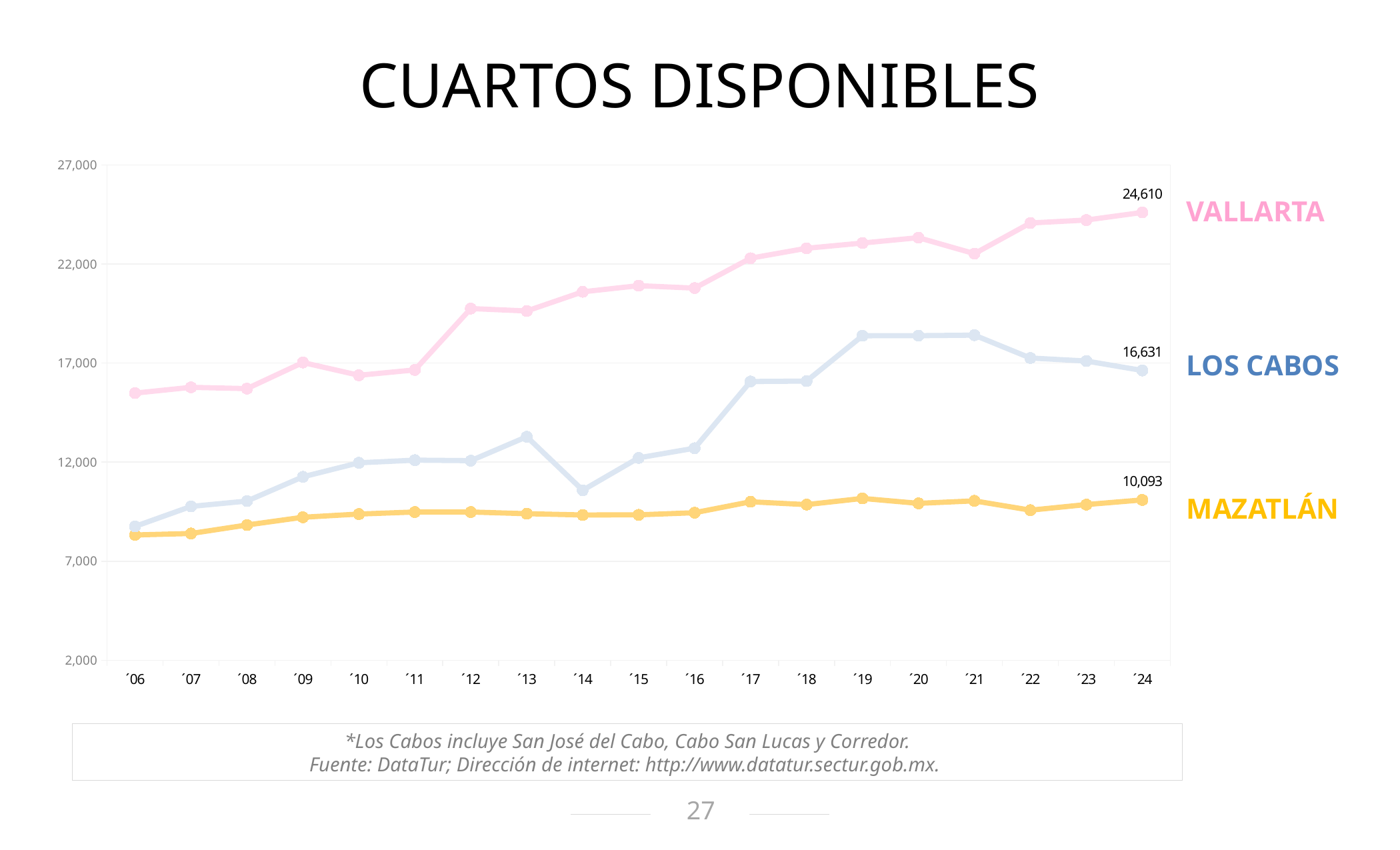
How many years are shown on the x axis? 19 What kind of chart is this? Line chart What is the difference between the Los Cabos and Mazatlán values in '24? 6,538 Which series has the highest value in '24? Vallarta Which series has the lowest value in '24? Mazatlán What is the value for Mazatlán in '24? 10,093 What is the value for Los Cabos in '24? 16,631 Is the value for Los Cabos in '19 greater or less than 17,000? greater How many series does the chart show? 3 Is the value for Vallarta in '06 greater or less than 17,000? less What is the difference between the Vallarta and Los Cabos values in '24? 7,979 What is the value for Vallarta in '24? 24,610